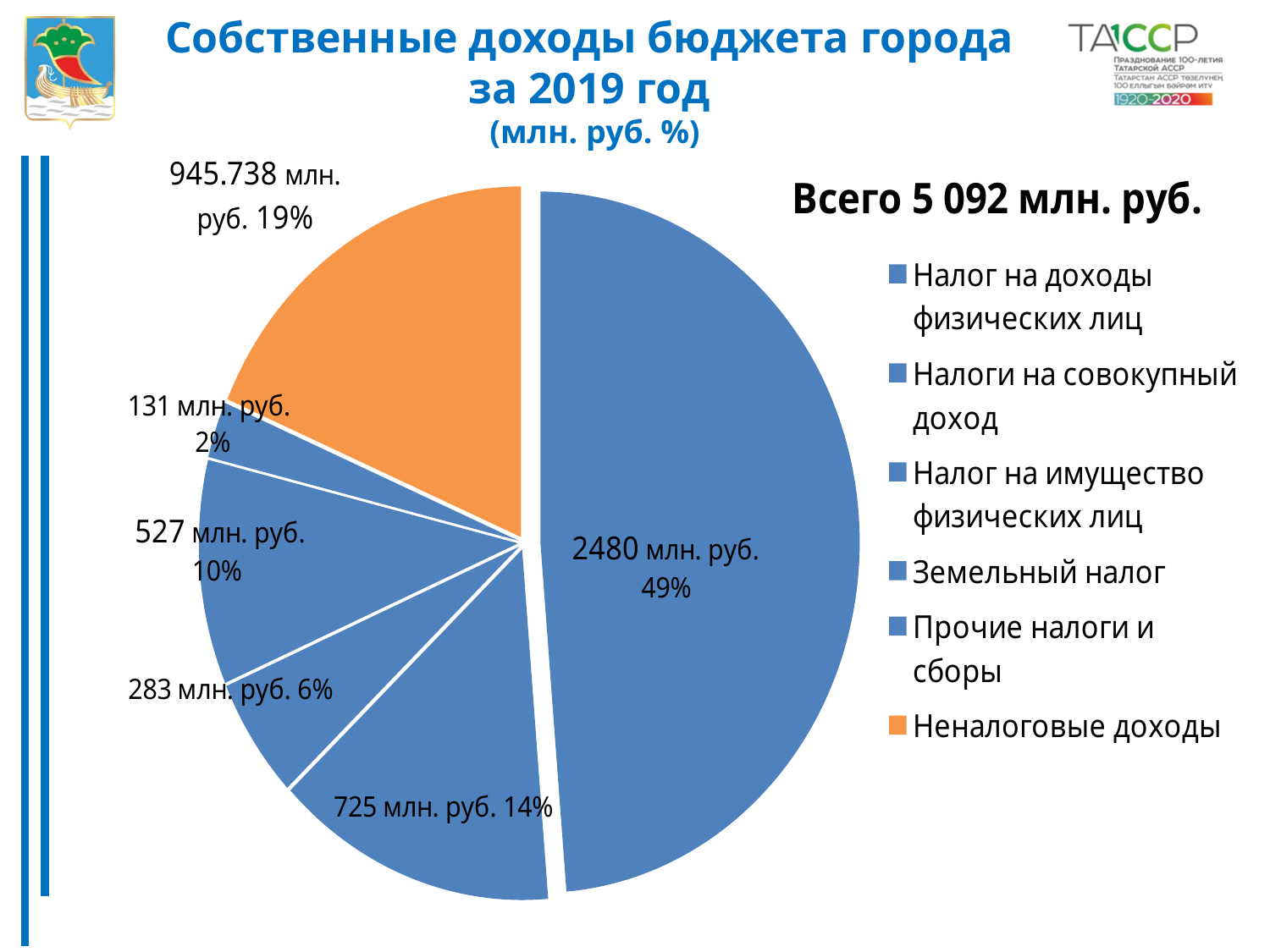
What is the value of the smallest slice of the pie? 131 млн. руб. What kind of chart is shown on the slide? pie chart What is the value shown for Неналоговые доходы? 945.738 млн. руб. What is the share of the largest slice of the pie? 49% What share is shown for the slice labelled 725 млн. руб.? 14% What colour is the slice for Неналоговые доходы? orange Which is larger: the slice with 10% or the slice with 6%? the slice with 10% (527 млн. руб.) How many slices does the pie chart have? 6 What is the difference between the slice labelled 2480 млн. руб. and the slice labelled 725 млн. руб.? 1755 млн. руб. What total amount is stated next to the pie chart? 5 092 млн. руб. What share of the pie does Неналоговые доходы take? 19% How many entries does the legend of the pie chart list? 6